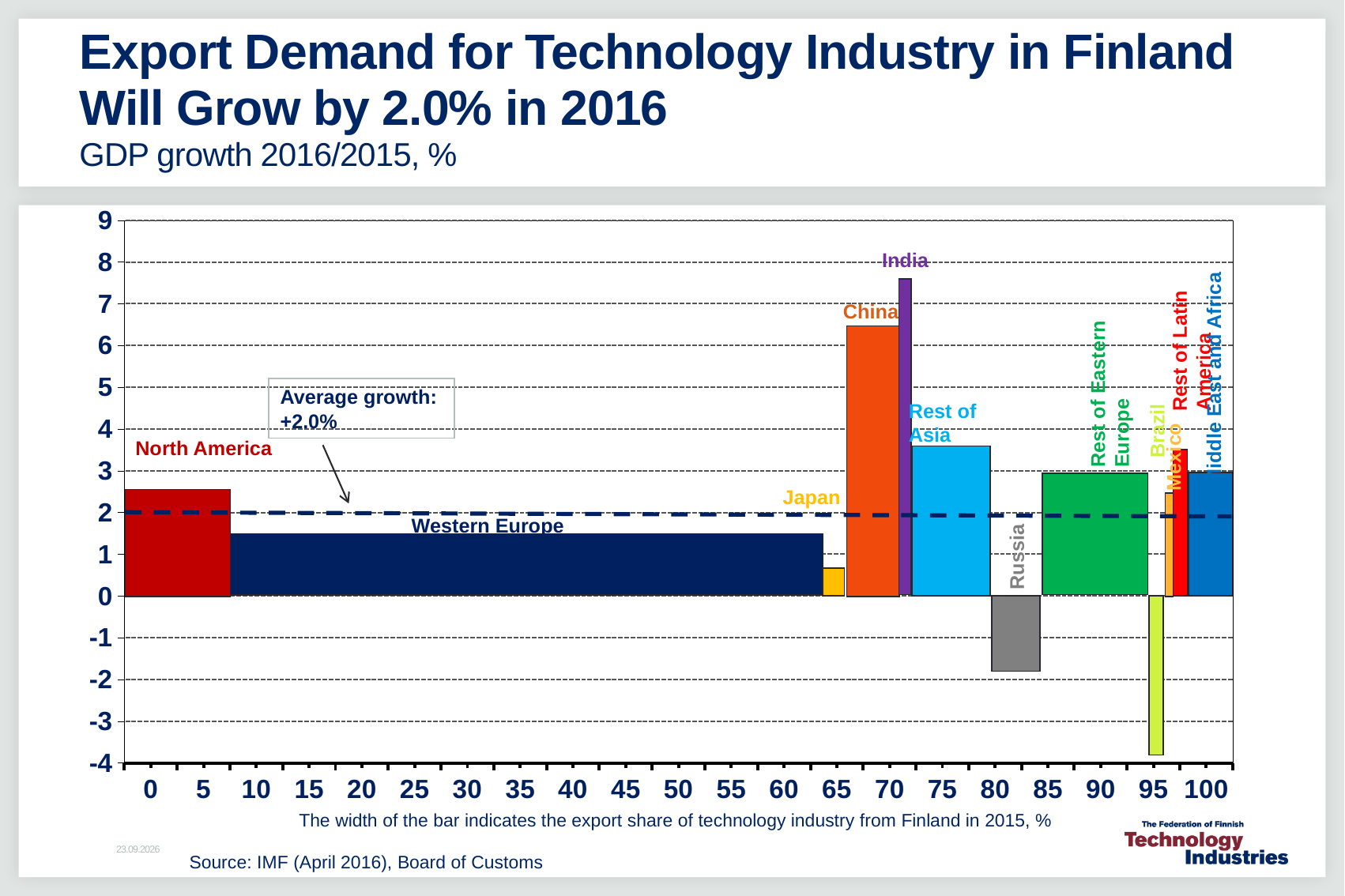
Is the GDP growth value for Russia greater or less than -1? less What average growth value is shown in the annotation box on the chart? +2.0% Which region has the highest GDP growth in the chart? India Which has the higher GDP growth, China or Rest of Asia? China Is the GDP growth value for China greater or less than 6? greater Is the GDP growth value for Brazil greater or less than -3? less According to the note below the chart, what does the width of each bar indicate? The export share of technology industry from Finland in 2015, % What kind of chart is shown on the slide? Bar chart Which has the higher GDP growth, North America or Western Europe? North America Which region has the lowest GDP growth in the chart? Brazil